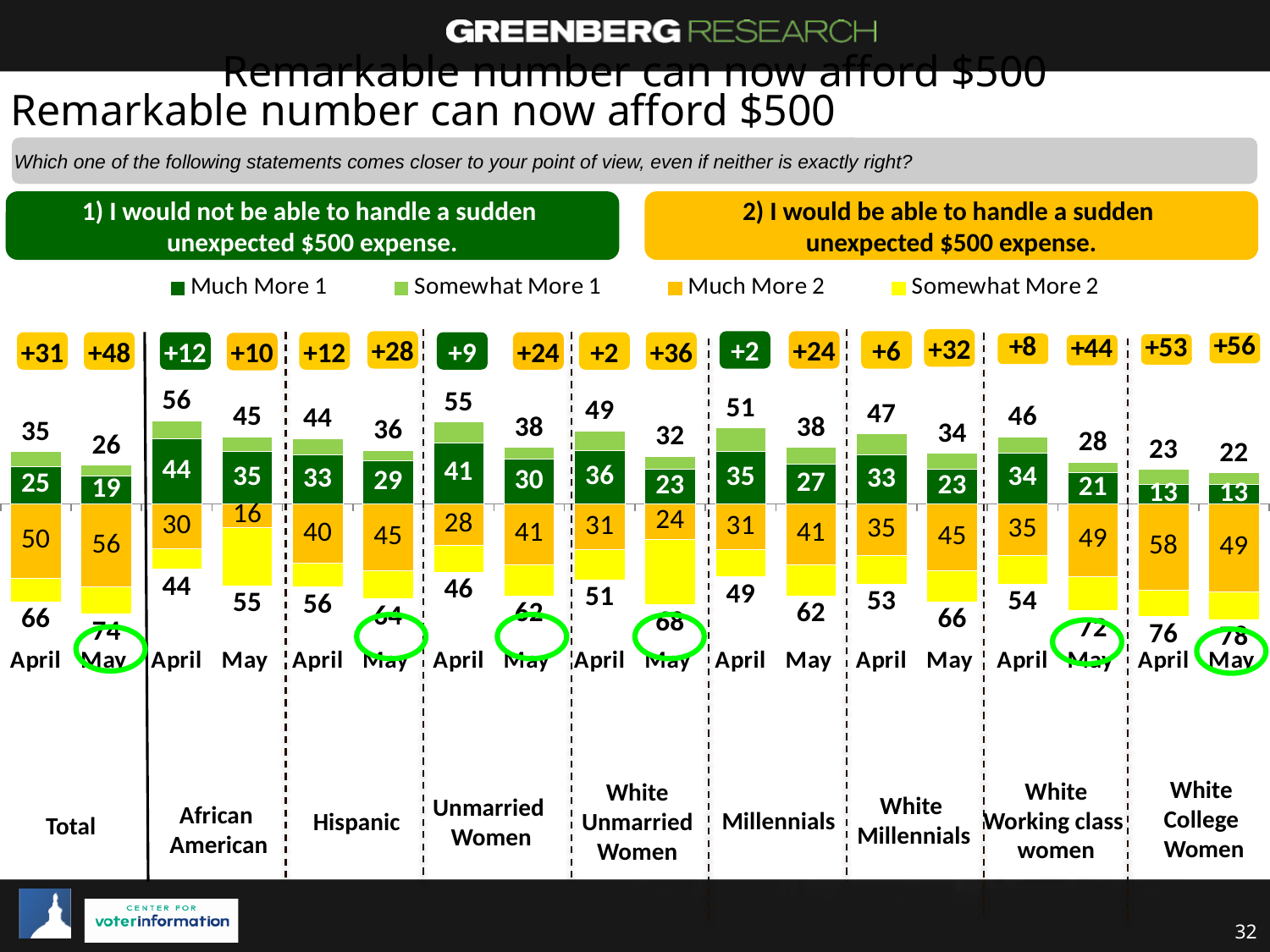
How many series does the legend list? 4 Which is larger: the 'Much More 2' value for Millennials in May or for White Millennials in May? White Millennials in May (45) For the Total group, does the net score rise or fall from April to May? Rise What kind of chart is shown on the slide? Stacked bar chart What is the 'Much More 1' value for Hispanic respondents in May? 29 What is the 'Much More 2' value for White College Women in April? 58 What is the net score shown above the May bar for the Total group? +48 What is the difference between the May and April 'would be able to handle' totals (bottom values) for the Total group? 8 Which group and month has the highest net score shown above the bars? White College Women, May (+56) How many demographic groups are shown along the bottom of the chart? 9 What is the combined 'would not be able to handle' value (top of the green bar) for African American respondents in April? 56 Which group and month has the highest combined 'would not be able to handle' value (top of the green bars)? African American, April (56)